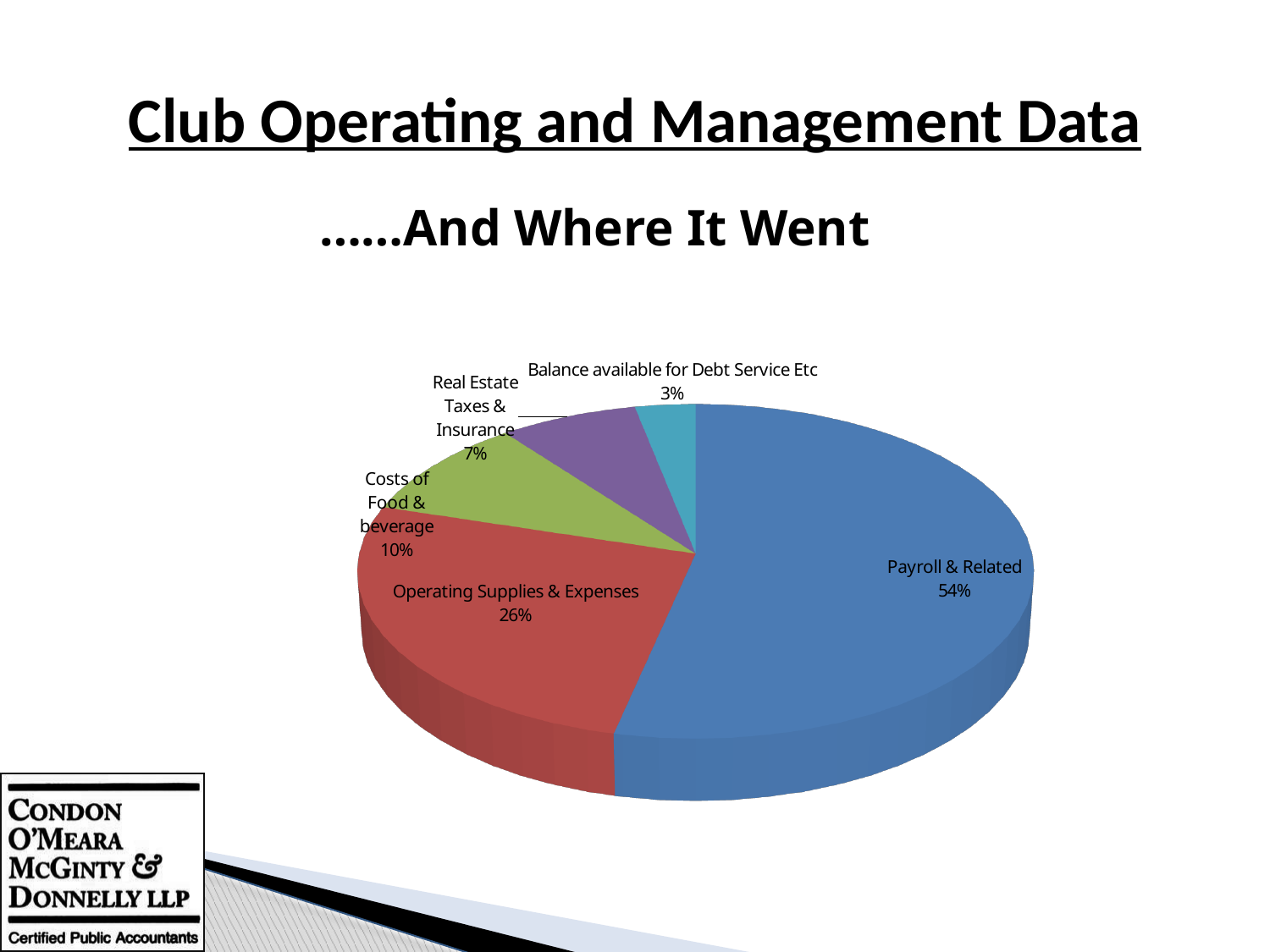
Which is larger, Costs of Food & beverage or Real Estate Taxes & Insurance? Costs of Food & beverage What percentage is shown for Operating Supplies & Expenses? 26% What share of the pie does Payroll & Related account for? 54% How many slices does the pie chart have? 5 What kind of chart is shown on the slide? pie chart What percentage is shown for Balance available for Debt Service Etc? 3% Which category has the largest slice of the pie? Payroll & Related What is the subtitle shown above the chart? ……And Where It Went What is the difference in percentage points between Payroll & Related and Operating Supplies & Expenses? 28 What percentage is shown for Real Estate Taxes & Insurance? 7% What percentage is shown for Costs of Food & beverage? 10% Which category has the smallest slice of the pie? Balance available for Debt Service Etc